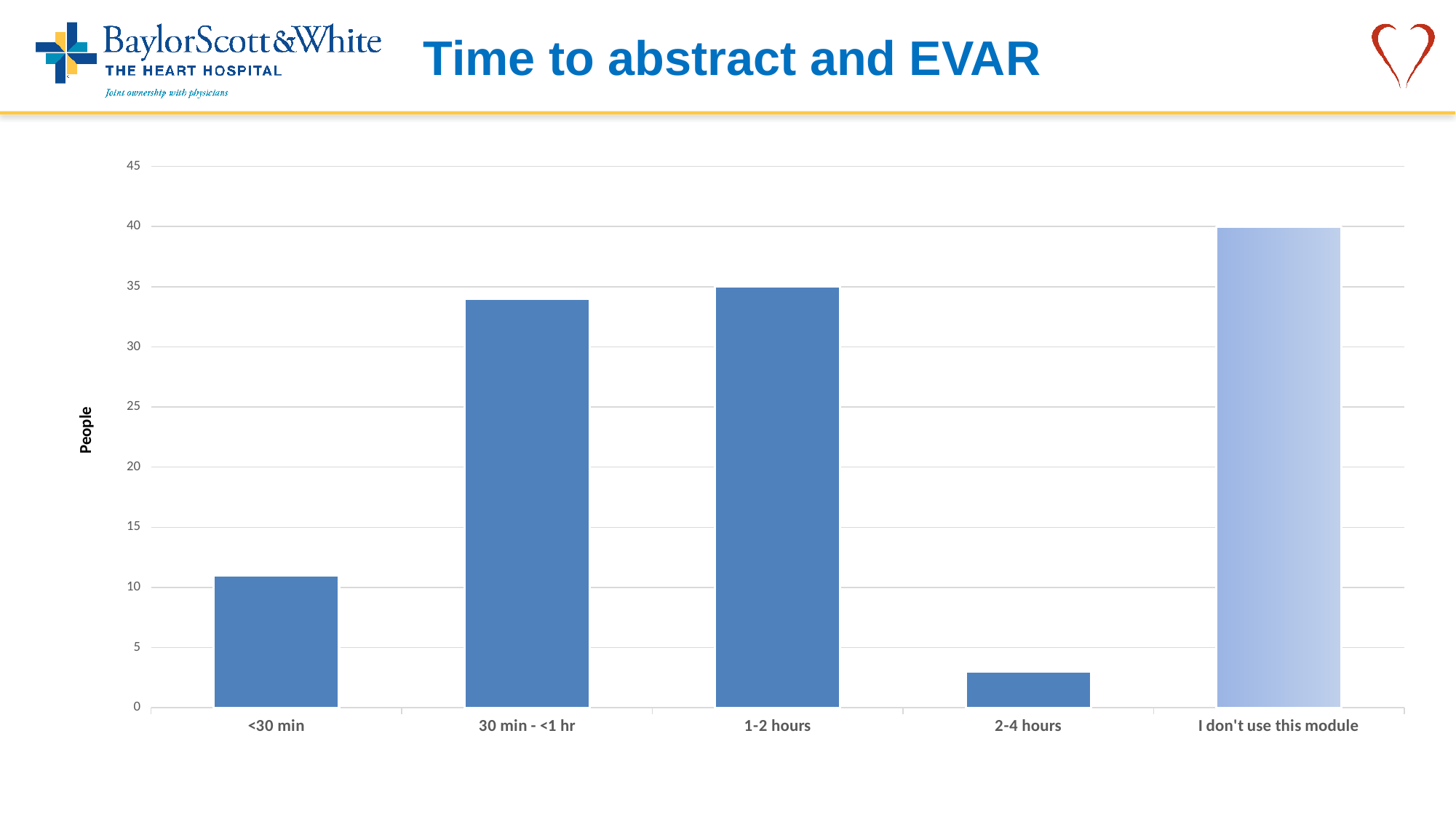
What is the label on the vertical axis of the chart? People Is the value for 2-4 hours greater or less than 5? less What kind of chart is shown on the slide? bar chart How many categories are shown on the x axis of the chart? 5 Which category has the lowest value in the chart? 2-4 hours Is the value for 1-2 hours greater or less than 40? less Which is larger, the value for <30 min or the value for 2-4 hours? <30 min Is the value for <30 min greater or less than 10? greater Which category has the highest value in the chart? I don't use this module What is the title of the slide containing the chart? Time to abstract and EVAR